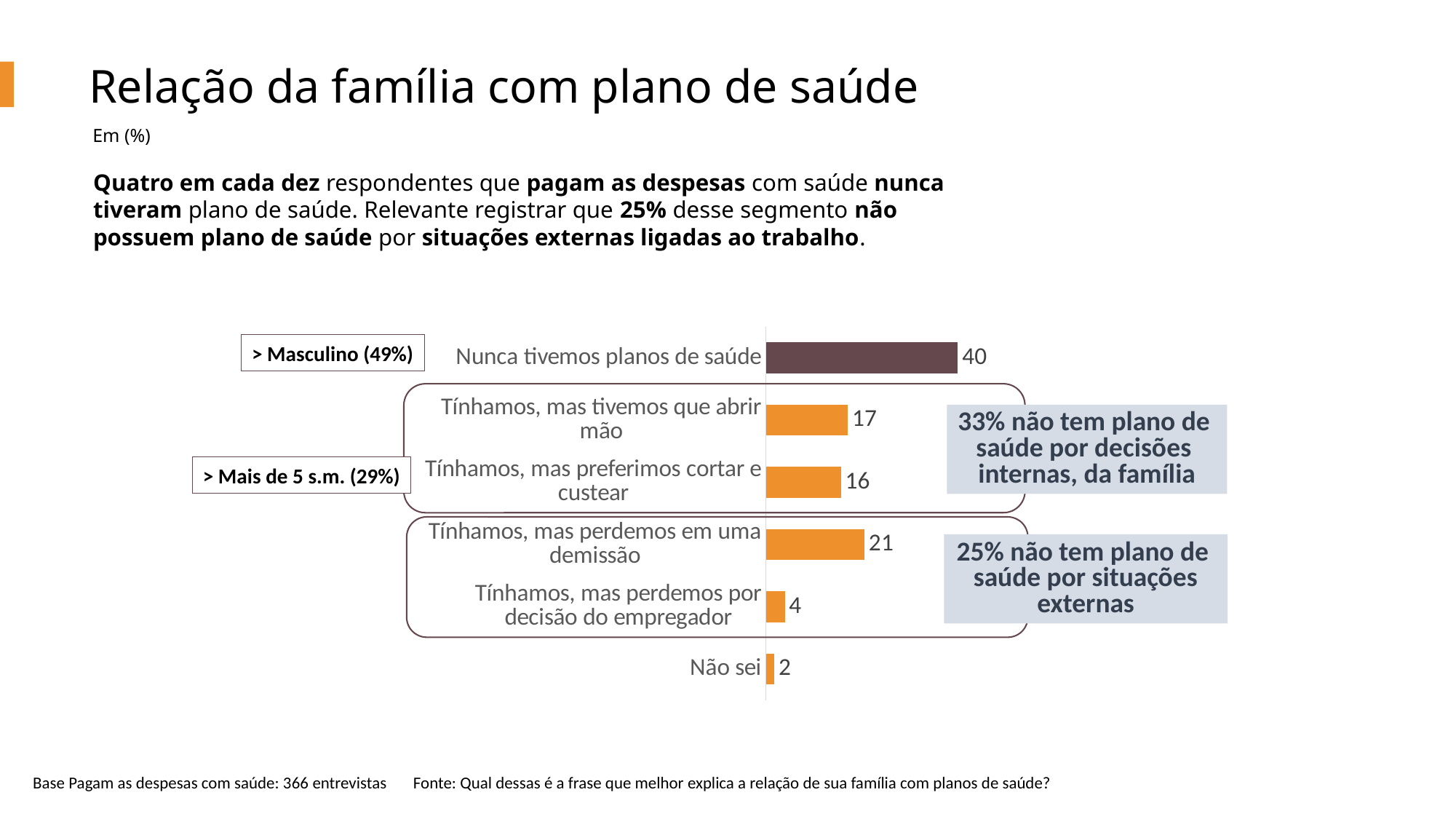
What is the total of "Tínhamos, mas tivemos que abrir mão" and "Tínhamos, mas preferimos cortar e custear"? 33 Which is larger: "Tínhamos, mas tivemos que abrir mão" or "Tínhamos, mas perdemos por decisão do empregador"? Tínhamos, mas tivemos que abrir mão What is the value for "Nunca tivemos planos de saúde"? 40 What is the value for "Não sei"? 2 Which category has the lowest value? Não sei What is the value for "Tínhamos, mas perdemos por decisão do empregador"? 4 Which category has the highest value? Nunca tivemos planos de saúde What is the difference between "Nunca tivemos planos de saúde" and "Tínhamos, mas perdemos em uma demissão"? 19 How many categories are shown in the chart? 6 Which bar is shown in a different colour from the others? Nunca tivemos planos de saúde What is the value for "Tínhamos, mas perdemos em uma demissão"? 21 What kind of chart is shown on the slide? Bar chart